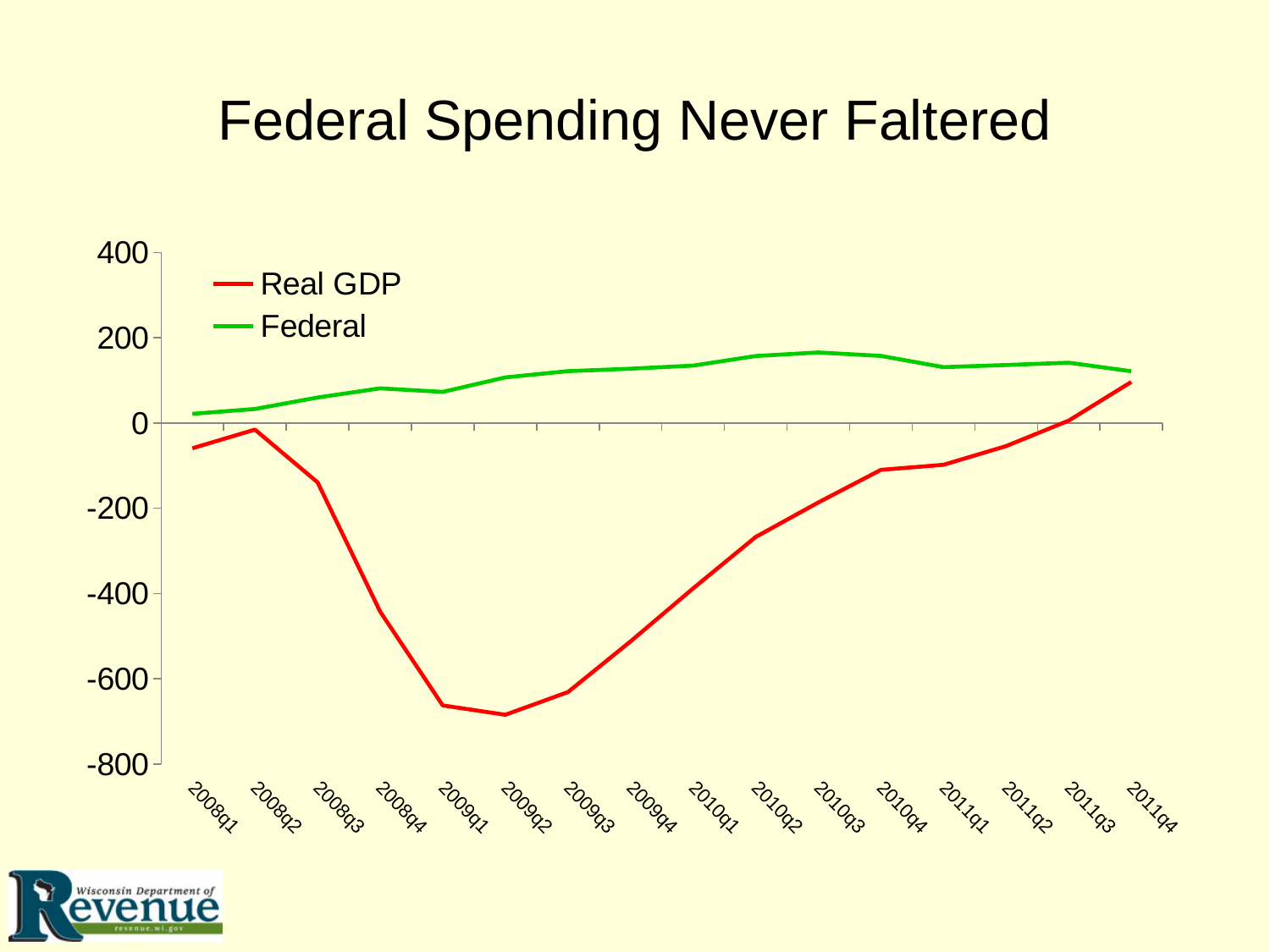
Is the Real GDP value for 2008q4 greater or less than -400? less At 2009q1, which series has the larger value, Real GDP or Federal? Federal How many series does the legend list? 2 Is the Federal value for 2010q3 greater or less than 100? greater What kind of chart is shown on the slide? line chart Does the Real GDP line rise or fall from 2009q2 to 2011q4? rise In which quarter does the Real GDP line reach its lowest point? 2009q2 In which quarter does the Real GDP line reach its highest point? 2011q4 Is the Real GDP value for 2011q4 greater or less than 0? greater What is the title of the chart? Federal Spending Never Faltered How many quarters are plotted along the x axis? 16